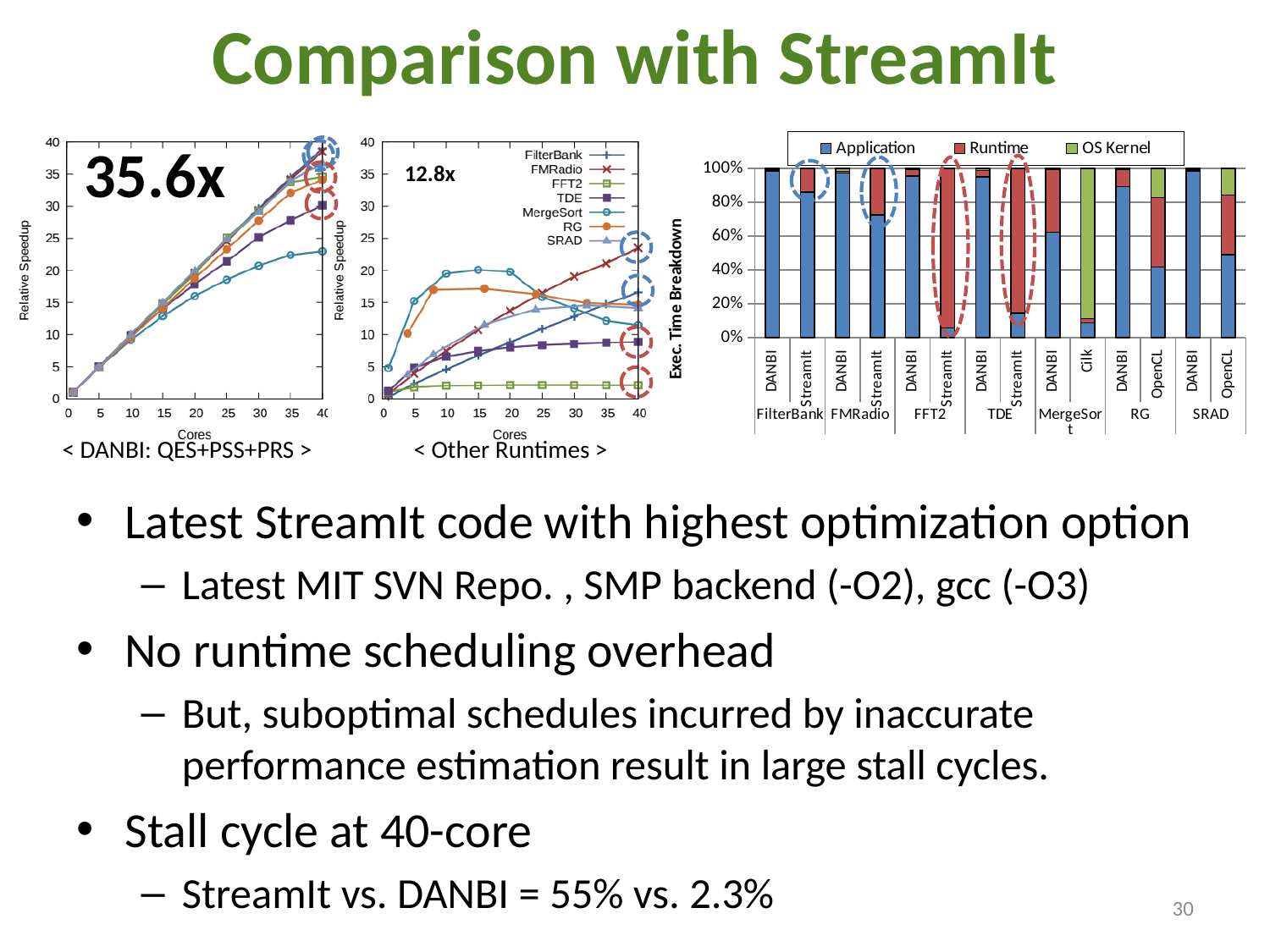
In the '< DANBI: QES+PSS+PRS >' chart, does the MergeSort line rise or fall as the number of cores increases? Rises What kind of chart is the 'Exec. Time Breakdown' chart on the right? Stacked bar chart In the '< Other Runtimes >' chart, which series has the highest relative speedup at 40 cores? FMRadio What kind of chart is the '< DANBI: QES+PSS+PRS >' chart on the left? Line chart In the '< Other Runtimes >' chart, is the FFT2 value at 40 cores greater or less than 5? less In the 'Exec. Time Breakdown' chart, is the Application share for StreamIt under FFT2 greater or less than 20%? less How many bars are plotted in the 'Exec. Time Breakdown' chart? 14 How many series does the legend of the '< Other Runtimes >' chart list? 7 In the 'Exec. Time Breakdown' chart, is the Application share for Cilk under MergeSort greater or less than 20%? less What peak speedup value is annotated on the '< DANBI: QES+PSS+PRS >' chart? 35.6x In the 'Exec. Time Breakdown' chart, which has the larger Application share under TDE, DANBI or StreamIt? DANBI How many series does the legend of the 'Exec. Time Breakdown' chart list? 3